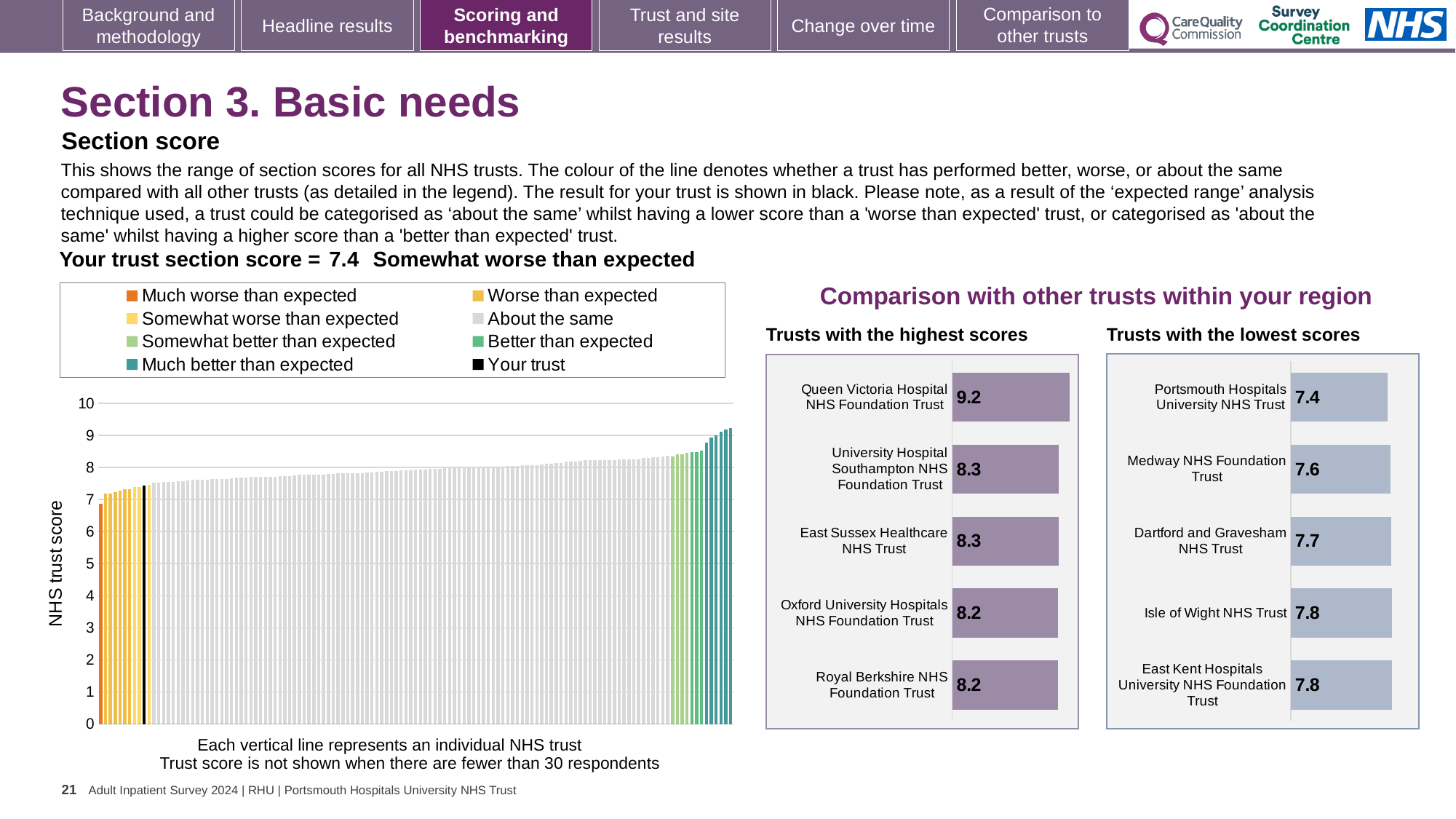
In the 'Trusts with the lowest scores' chart, which trust has the lowest score? Portsmouth Hospitals University NHS Trust In the 'Trusts with the highest scores' chart, which trust has the highest score? Queen Victoria Hospital NHS Foundation Trust In the 'Trusts with the highest scores' chart, what is the score for Oxford University Hospitals NHS Foundation Trust? 8.2 In the 'Trusts with the highest scores' chart, what is the difference between the scores of Queen Victoria Hospital NHS Foundation Trust and Royal Berkshire NHS Foundation Trust? 1.0 In the 'Trusts with the lowest scores' chart, which has the larger score: Dartford and Gravesham NHS Trust or Portsmouth Hospitals University NHS Trust? Dartford and Gravesham NHS Trust In the main chart on the left, do the trust scores rise or fall from left to right? Rise How many entries does the legend of the main chart on the left list? 8 In the 'Trusts with the highest scores' chart, what is the score for Queen Victoria Hospital NHS Foundation Trust? 9.2 How many trusts are shown in the 'Trusts with the lowest scores' chart? 5 In the 'Trusts with the lowest scores' chart, what is the score for Medway NHS Foundation Trust? 7.6 What kind of chart is the main chart on the left showing NHS trust scores? Bar chart In the main chart on the left showing NHS trust scores, what is the section score for your trust? 7.4